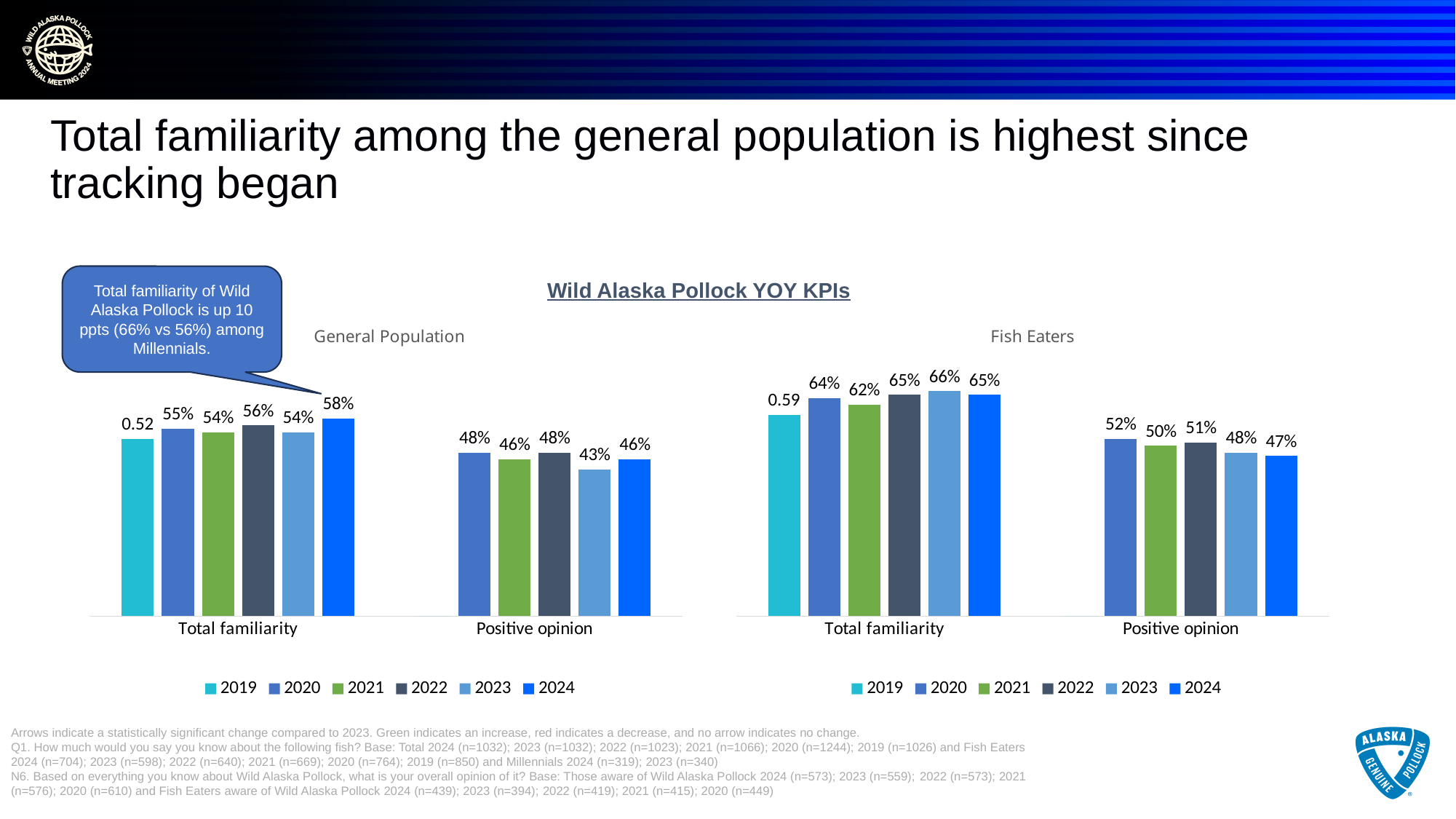
In the Fish Eaters chart, is the 2022 Total familiarity value larger or smaller than the 2021 Total familiarity value? larger What type of chart is used for the Fish Eaters data? bar chart In the General Population chart, which year has the highest Total familiarity value? 2024 In the Fish Eaters chart, which year has the highest Positive opinion value? 2020 In the Fish Eaters chart, what is the 2024 value for Positive opinion? 47% How many series does the legend of the General Population chart list? 6 In the Fish Eaters chart, what is the 2023 value for Total familiarity? 66% In the General Population chart, what is the 2023 value for Positive opinion? 43% In the General Population chart, what is the difference between the 2024 and 2023 Total familiarity values? 4 percentage points In the General Population chart, which year has the lowest Positive opinion value? 2023 In the General Population chart, what is the 2024 value for Total familiarity? 58% In the Fish Eaters chart, what is the difference between the 2020 and 2024 Positive opinion values? 5 percentage points